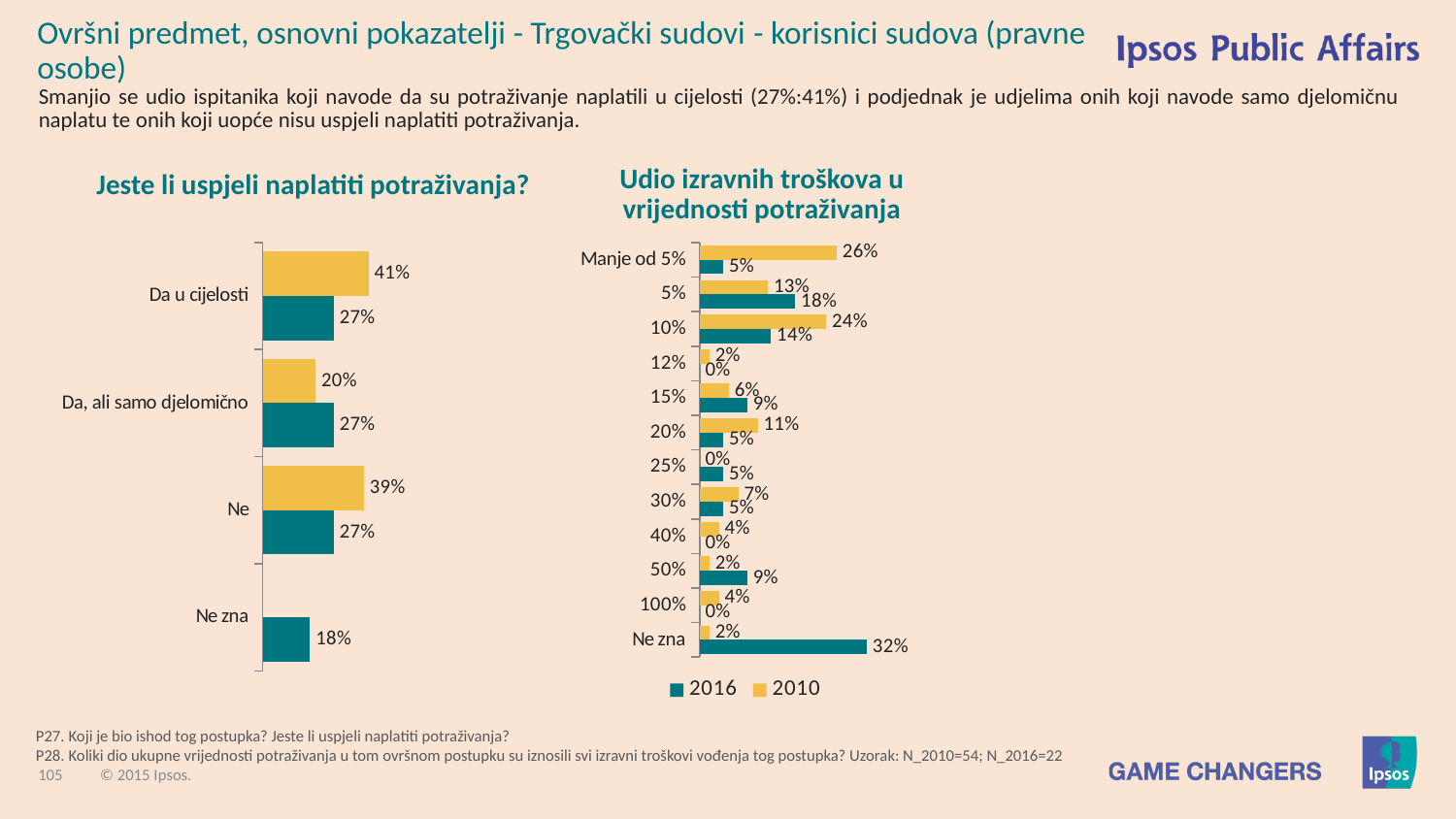
In the chart 'Jeste li uspjeli naplatiti potraživanja?', how many categories are shown? 4 In the chart 'Jeste li uspjeli naplatiti potraživanja?', what is the 2016 value for 'Ne zna'? 18% In the chart 'Udio izravnih troškova u vrijednosti potraživanja', what is the 2010 value for 'Manje od 5%'? 26% In the chart 'Udio izravnih troškova u vrijednosti potraživanja', which is larger for the '10%' category: the 2010 value or the 2016 value? 2010 In the chart 'Udio izravnih troškova u vrijednosti potraživanja', what is the difference between the 2016 and 2010 values for '5%'? 5 percentage points In the chart 'Udio izravnih troškova u vrijednosti potraživanja', which category has the highest 2016 value? Ne zna What type of chart is 'Udio izravnih troškova u vrijednosti potraživanja'? Bar chart In the chart 'Jeste li uspjeli naplatiti potraživanja?', which category has the highest 2010 value? Da u cijelosti In the chart 'Udio izravnih troškova u vrijednosti potraživanja', what is the 2016 value for 'Ne zna'? 32% How many series does the legend list? 2 In the chart 'Jeste li uspjeli naplatiti potraživanja?', what is the difference between the 2010 and 2016 values for 'Da u cijelosti'? 14 percentage points In the chart 'Jeste li uspjeli naplatiti potraživanja?', what is the 2010 value for 'Da u cijelosti'? 41%